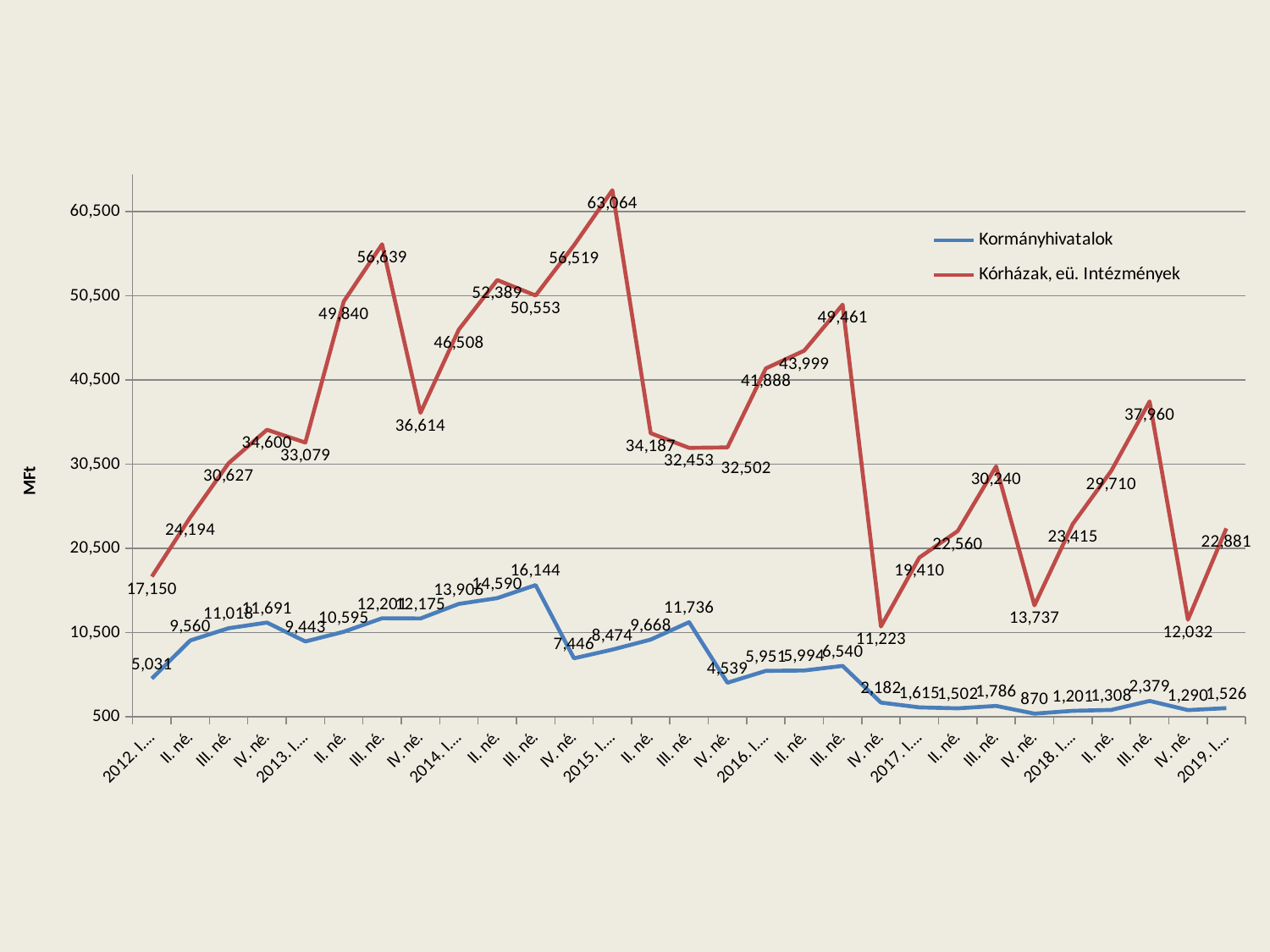
What is the highest value plotted for Kormányhivatalok? 16,144 What is the value for Kórházak, eü. Intézmények at the first point (2012. I.)? 17,150 What is the highest value plotted for Kórházak, eü. Intézmények? 63,064 Is the peak value of the Kórházak, eü. Intézmények line greater or less than 60,500? greater How many series does the legend list? 2 Does the Kormányhivatalok line end higher or lower than it starts, comparing 2012. I. with 2019. I.? lower What is the difference between the Kórházak, eü. Intézmények value (22,881) and the Kormányhivatalok value (1,526) at the last point (2019. I.)? 21,355 What is the value for Kormányhivatalok at the first point (2012. I.)? 5,031 What is the lowest value plotted for Kormányhivatalok? 870 What kind of chart is shown on the slide? line chart Which series has the larger value at the last point (2019. I.): Kormányhivatalok or Kórházak, eü. Intézmények? Kórházak, eü. Intézmények What label is shown on the vertical axis? MFt